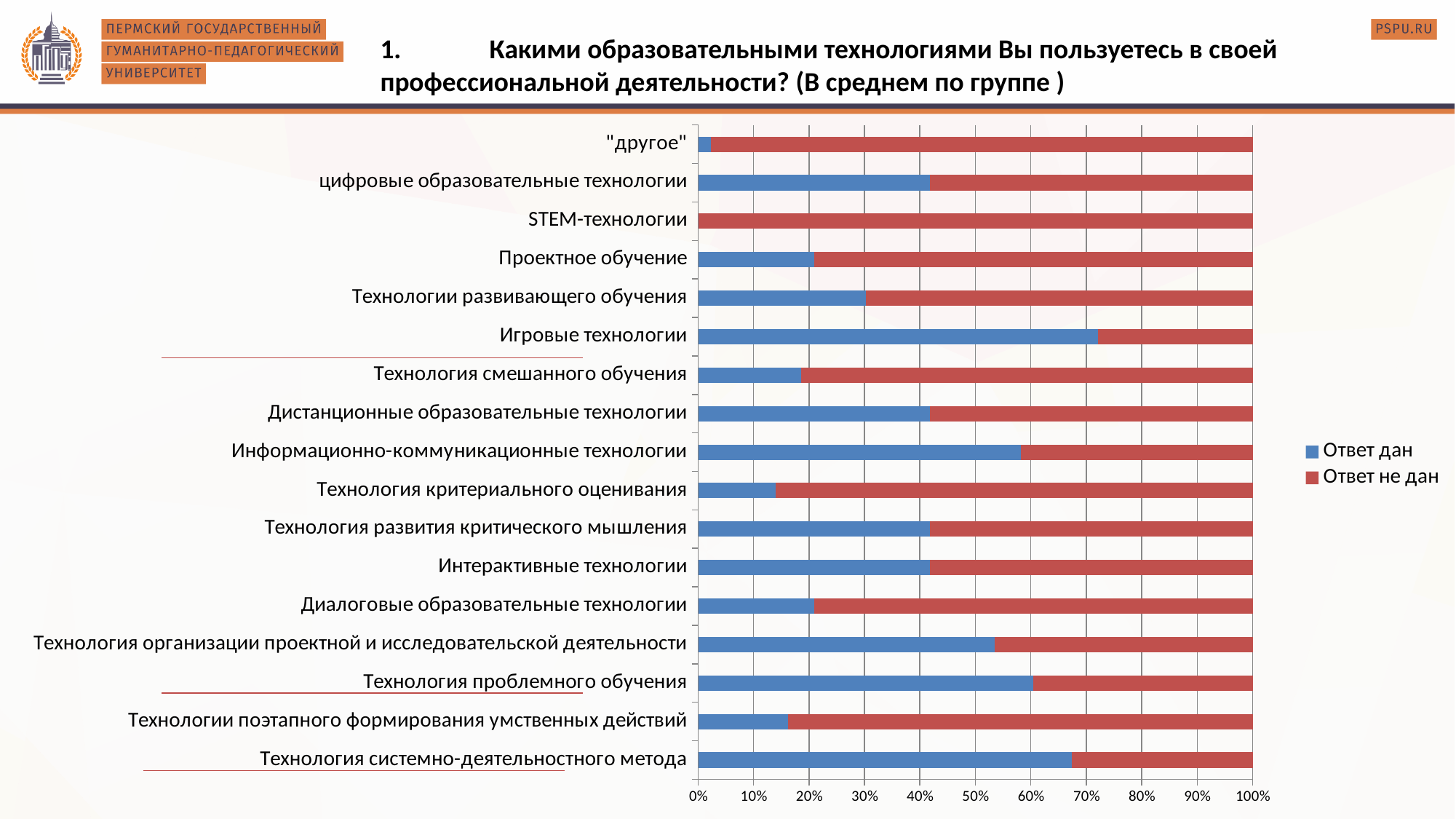
Which category has the largest "Ответ дан" share? Игровые технологии How many series does the legend list? 2 Which colour represents the "Ответ не дан" series? red Is the "Ответ дан" value for Проектное обучение greater or less than 30%? less Is the "Ответ дан" value for Игровые технологии greater or less than 60%? greater What kind of chart is shown on the slide? bar chart Is the "Ответ дан" value for Технология критериального оценивания greater or less than 20%? less Which has a larger "Ответ дан" share: Технология проблемного обучения or Технологии поэтапного формирования умственных действий? Технология проблемного обучения What is the total of the stacked bar for Дистанционные образовательные технологии? 100% Which category has the smallest "Ответ дан" share? STEM-технологии How many categories (technologies) are plotted on the chart? 17